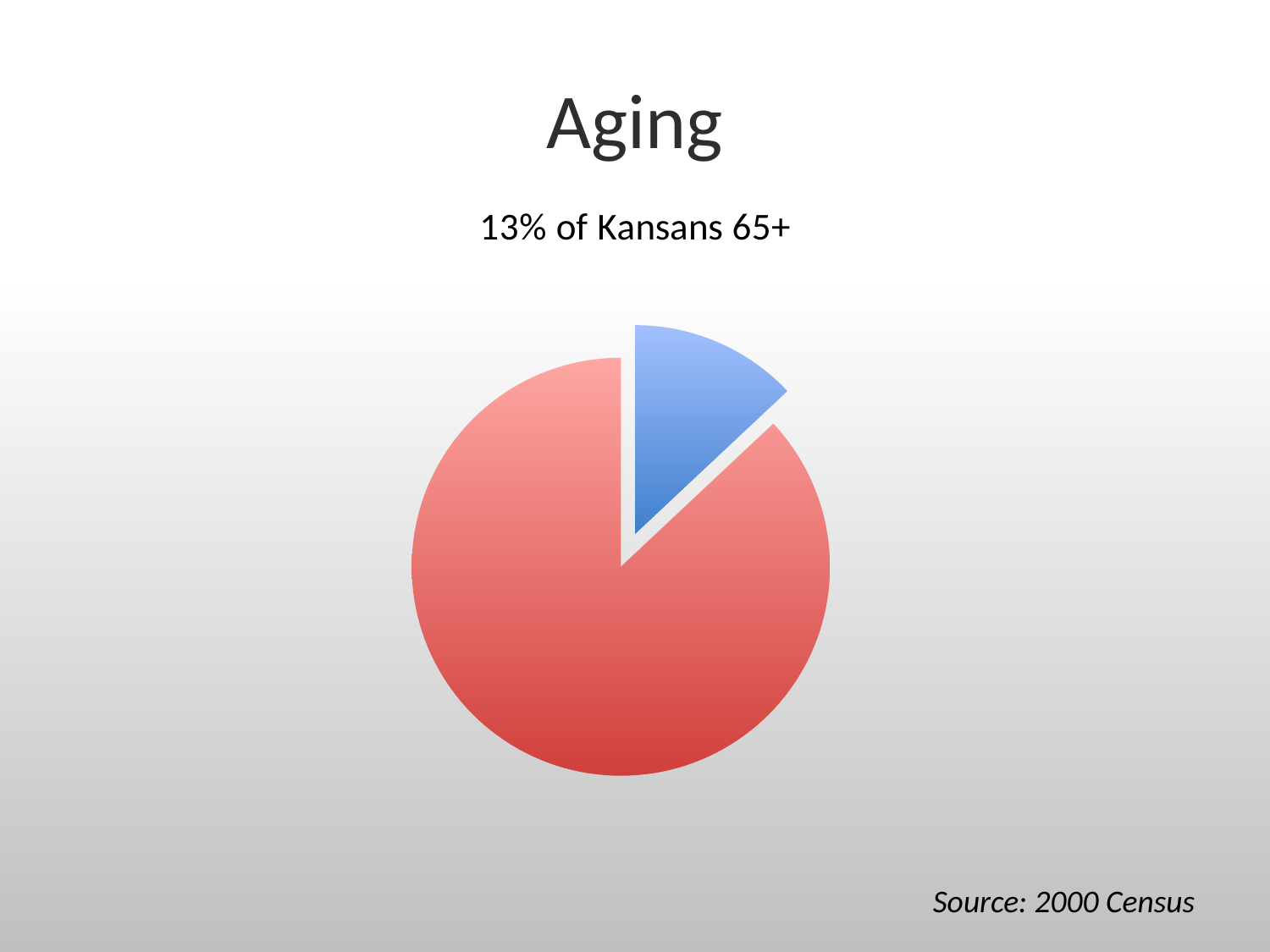
Which slice of the pie chart is the smallest? the blue slice Is the share represented by the red slice greater or less than 50%? greater What is the title of the slide containing the pie chart? Aging Which slice of the pie chart is larger, the blue slice or the red slice? the red slice How many slices does the pie chart have? 2 What source is cited for the data in the pie chart? 2000 Census Is the share represented by the blue slice greater or less than 50%? less What kind of chart is shown on the slide? pie chart What share of Kansans are 65+, according to the slide? 13%